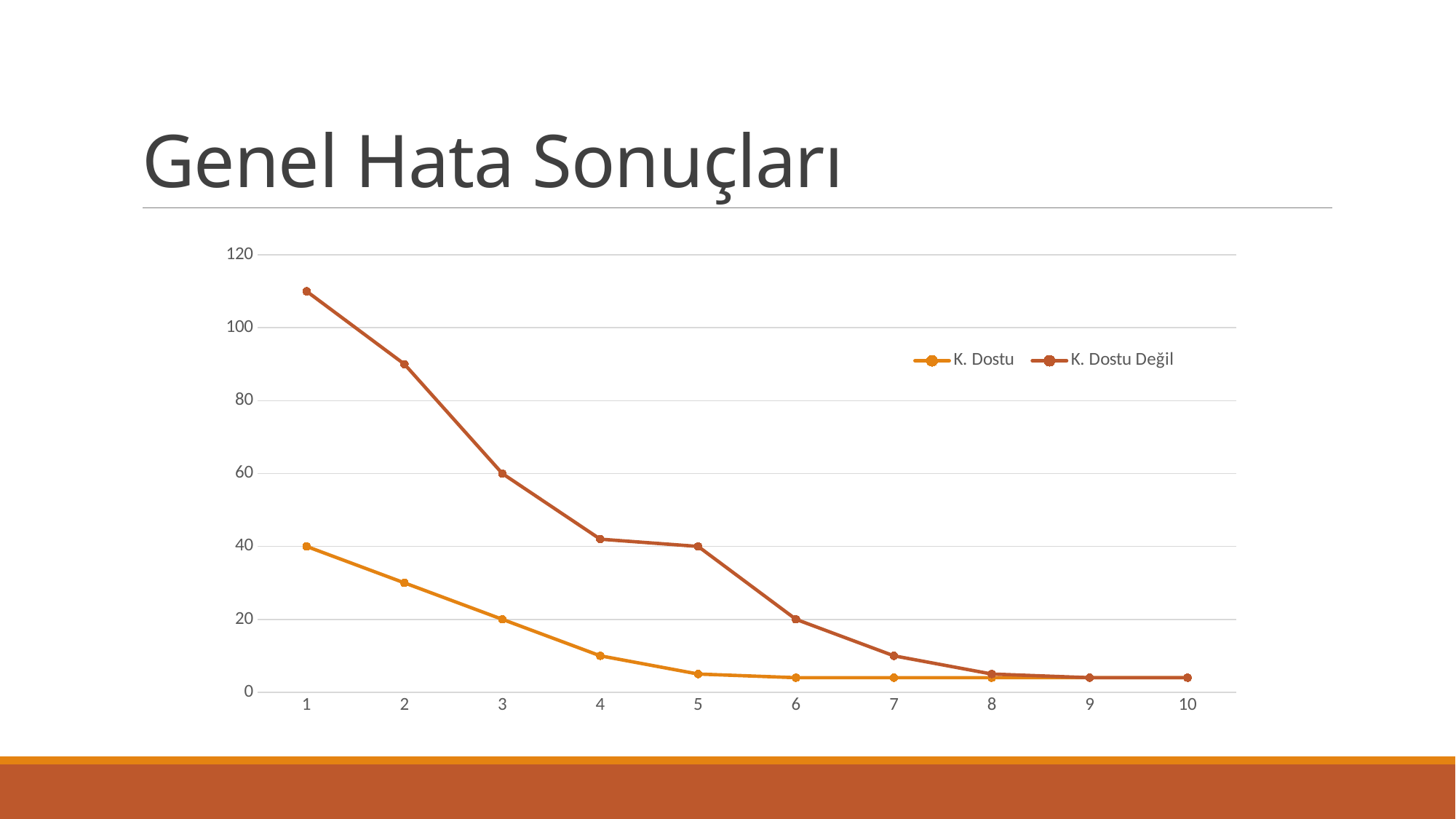
Which series has the larger value at x = 4, K. Dostu or K. Dostu Değil? K. Dostu Değil Is the value for K. Dostu Değil at x = 1 greater or less than 100? greater What is the value of K. Dostu Değil at x = 3? 60 What is the value of K. Dostu at x = 1? 40 How many points are plotted along the x axis for each series? 10 Is the value for K. Dostu at x = 2 greater or less than 40? less What kind of chart is shown on the slide? line chart Do the values of K. Dostu Değil rise or fall from x = 1 to x = 10? fall At which x value is K. Dostu Değil highest? 1 What is the value of K. Dostu Değil at x = 5? 40 What is the value of K. Dostu at x = 3? 20 How many series does the legend list? 2